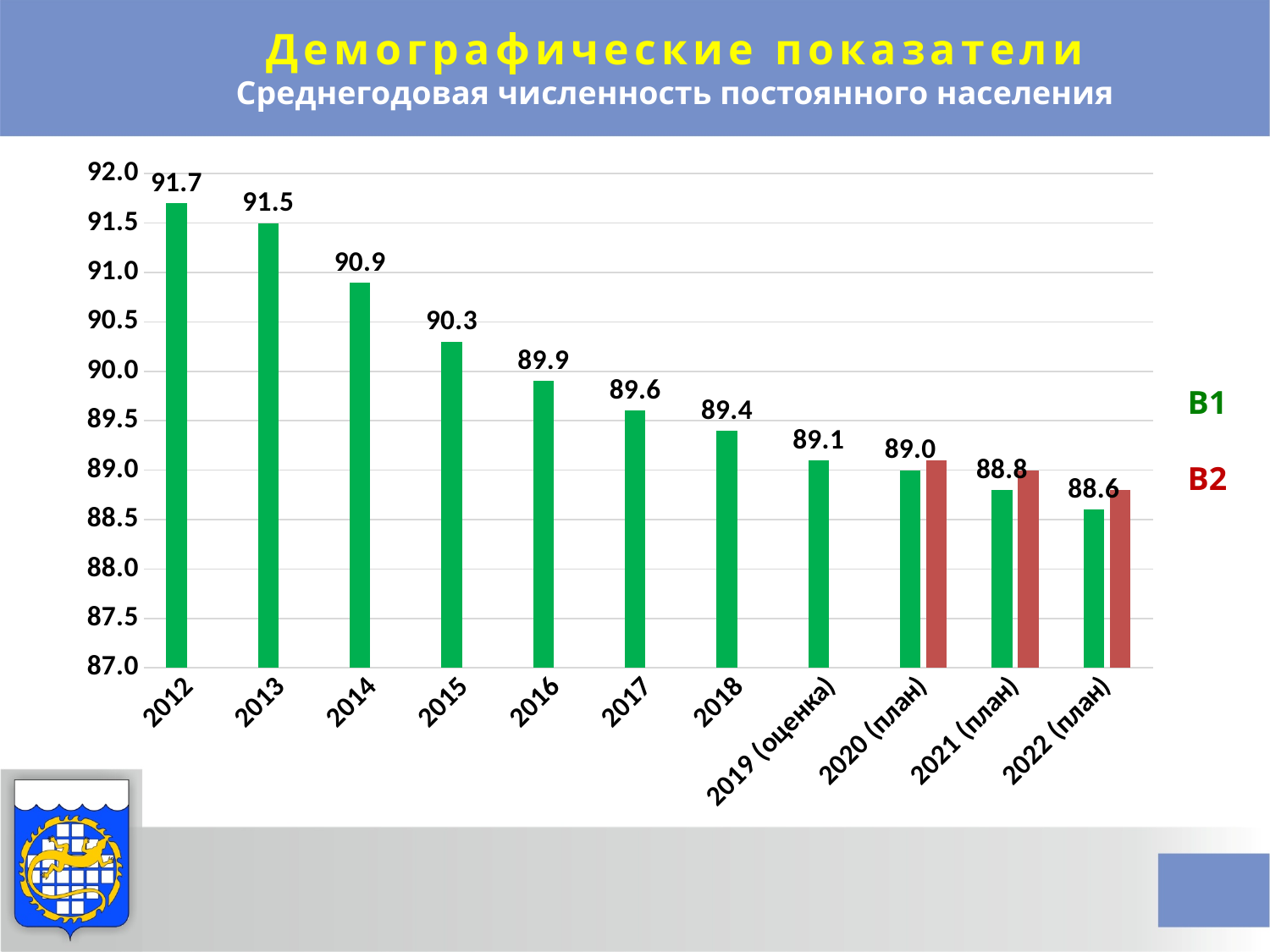
What is the difference between the values for 2012 and 2013? 0.2 Which category has the lowest labelled value? 2022 (план) What is the value for 2015? 90.3 What is the value for 2012? 91.7 What is the labelled value for 2019 (оценка)? 89.1 How many series does the legend list? 2 Which year has the highest value? 2012 Is the В2 value for 2022 (план) greater or less than 89.0? less Do the values rise or fall from 2012 to 2022 (план)? fall What is the value for 2018? 89.4 How many categories are shown on the x axis? 11 Which is larger, the value for 2014 or the value for 2016? 2014